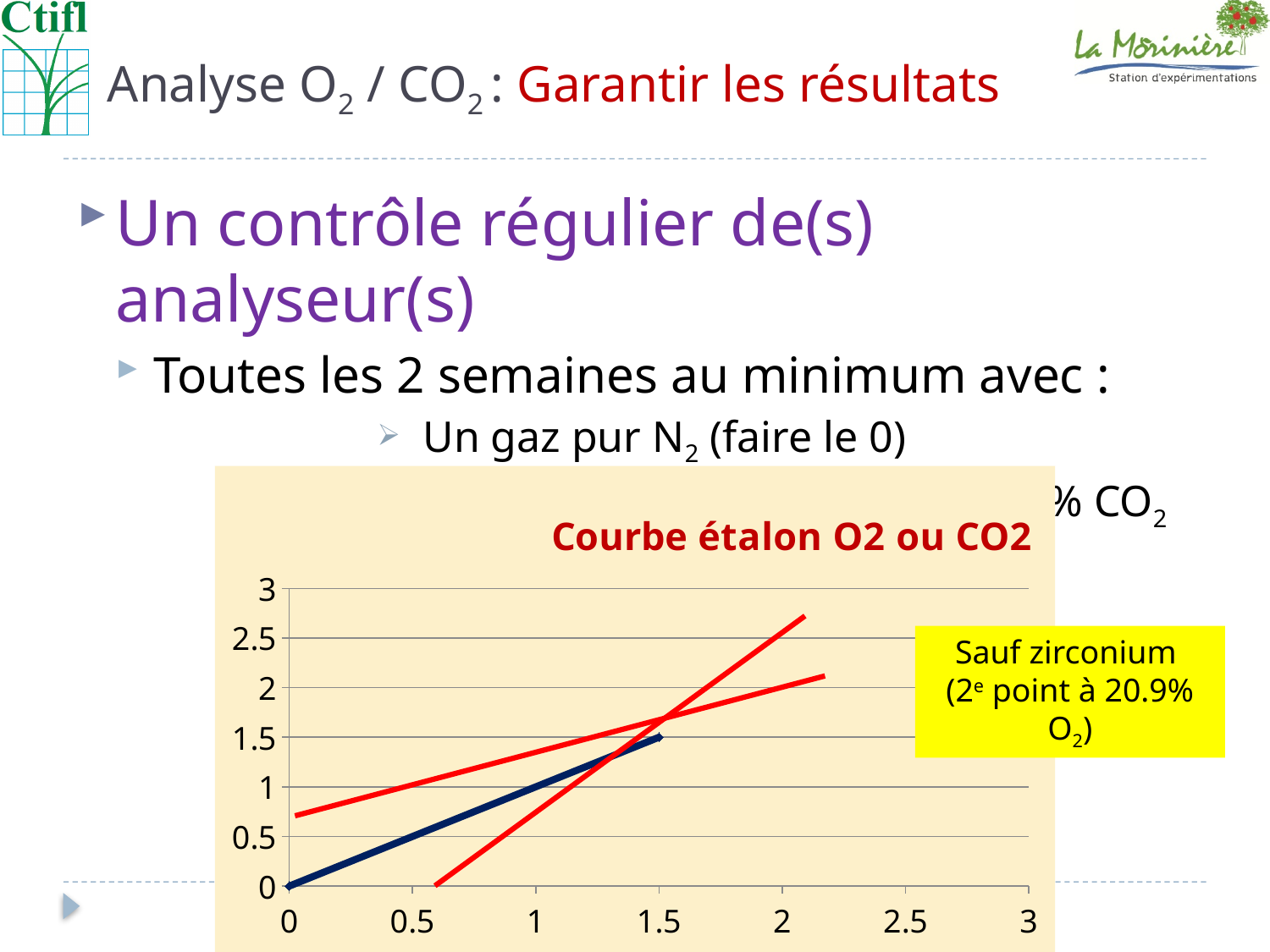
Do the lines on the chart rise or fall as the x-axis value increases? rise How many lines are plotted on the chart? 3 What is the highest value shown on the y-axis of the chart? 3 What is the title of the chart? Courbe étalon O2 ou CO2 At x = 0.5, which line has the larger value: the shallower red line or the dark blue line? the shallower red line At what x value does the dark blue line start? 0 What type of chart is shown on the slide? line chart Is the value of the shallower red line at x = 0 greater or less than 0.5? greater How many tick labels are shown on the x-axis? 7 Is the value of the steeper red line at x = 1 greater or less than 1? less What is the y value of the dark blue line at x = 1.5? 1.5